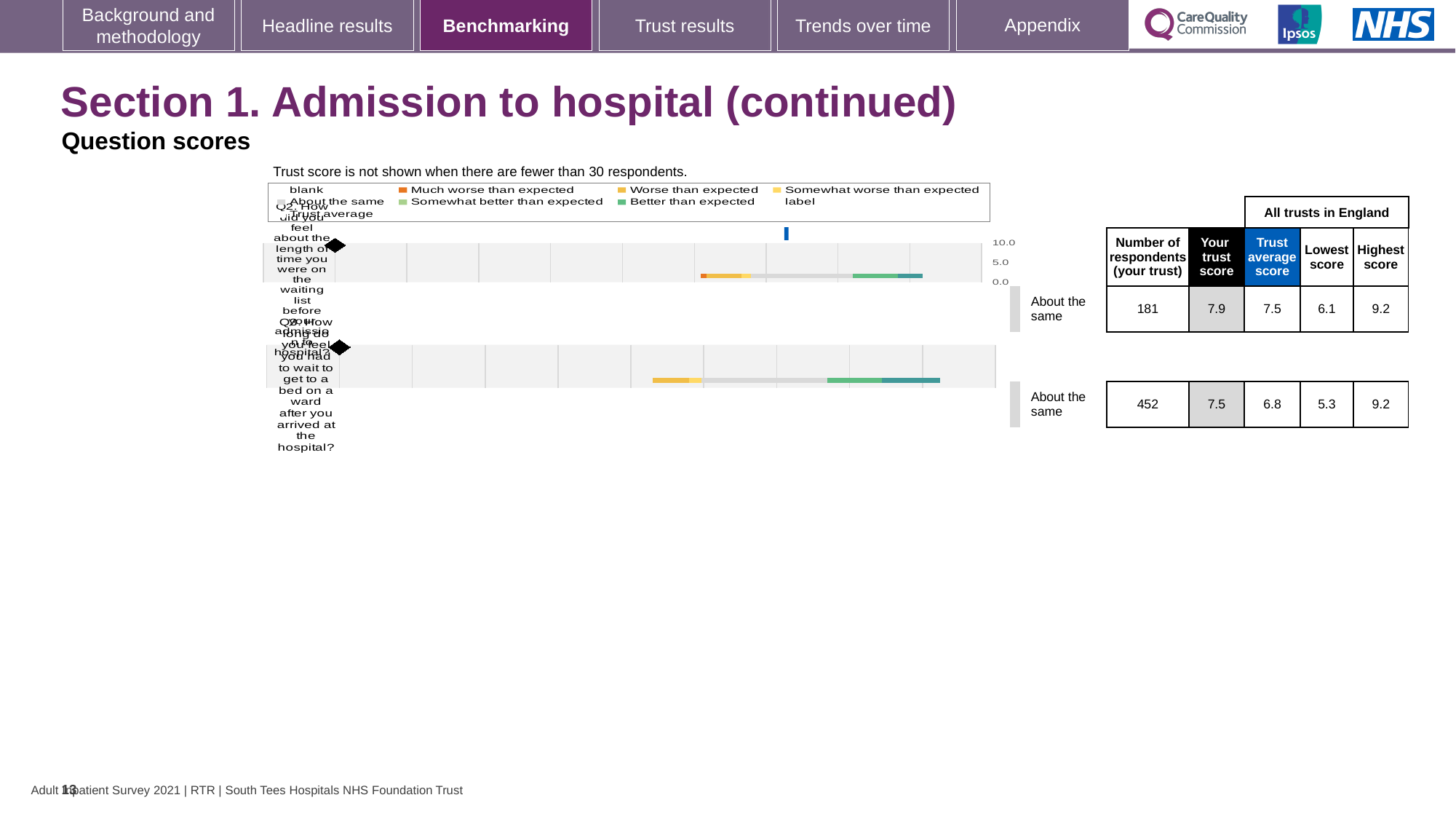
How many respondents (your trust) are shown for Q2? 181 What is the trust average score for all trusts in England for Q2? 7.5 By how much does the trust's score for Q2 exceed the trust average score for Q2? 0.4 What benchmark category is shown next to the chart for Q3? About the same What is the 'Your trust score' for Q3 (how long did you feel you had to wait to get to a bed on a ward)? 7.5 How many questions are plotted in the benchmarking chart? 2 What is the 'Your trust score' for Q2 (how did you feel about the length of time you were on the waiting list before admission)? 7.9 What is the lowest score among all trusts in England for Q3? 5.3 Which question has more respondents from your trust, Q2 or Q3? Q3 How many respondents (your trust) are shown for Q3? 452 What kind of chart is used to show the question scores? Bar chart What is the highest score among all trusts in England for Q2? 9.2